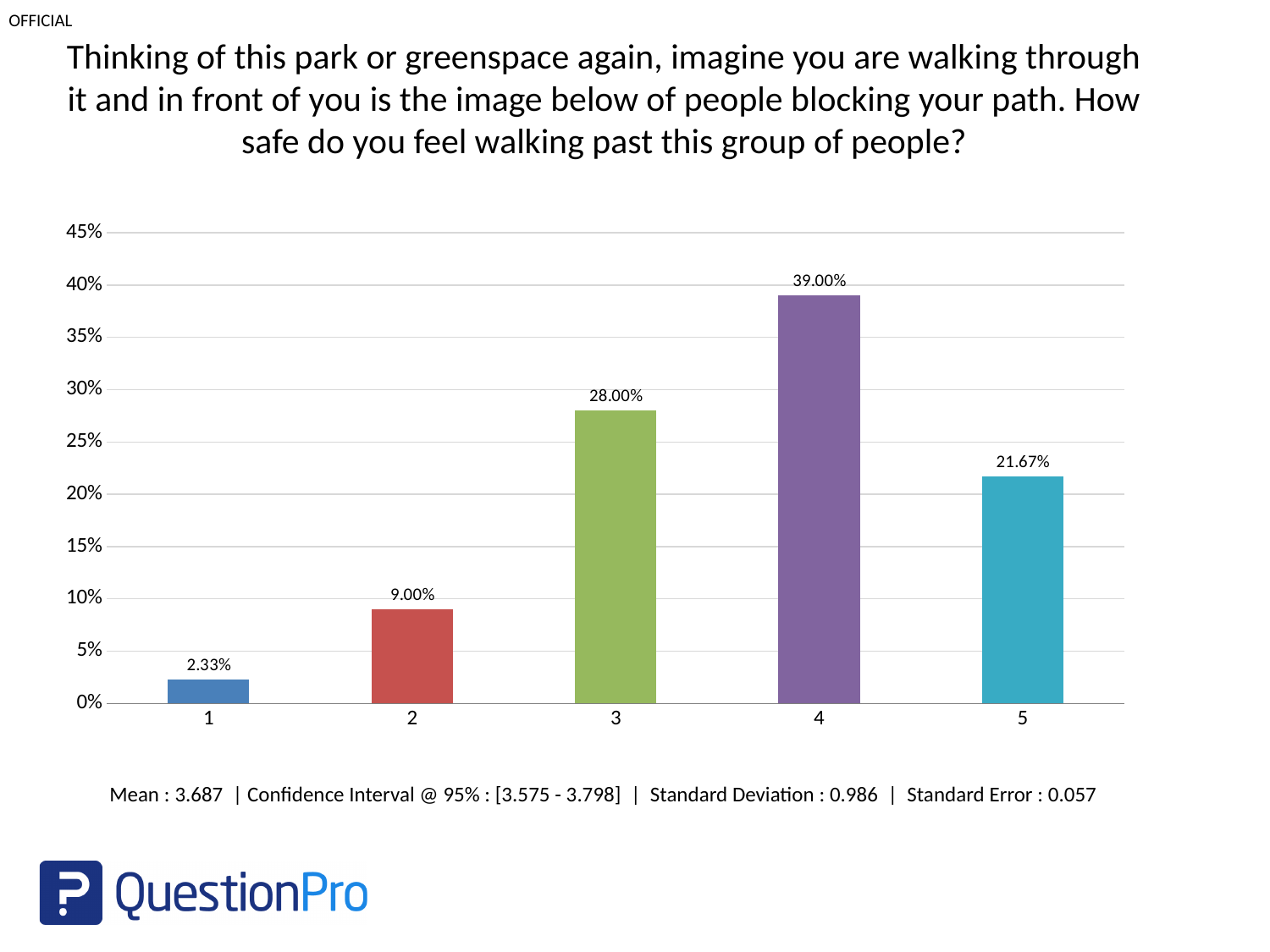
Is the value for category 3 greater or less than 25%? greater What kind of chart is shown on the slide? bar chart Which category has the highest value? 4 How many categories are shown on the x axis? 5 Which is larger, the value for category 3 or the value for category 5? 3 Which category has the lowest value? 1 What is the value for category 1? 2.33% What is the value for category 5? 21.67% What is the difference between the values for category 4 and category 3? 11.00% What is the mean value reported below the chart? 3.687 What is the difference between the values for category 2 and category 1? 6.67% What is the value for category 4? 39.00%